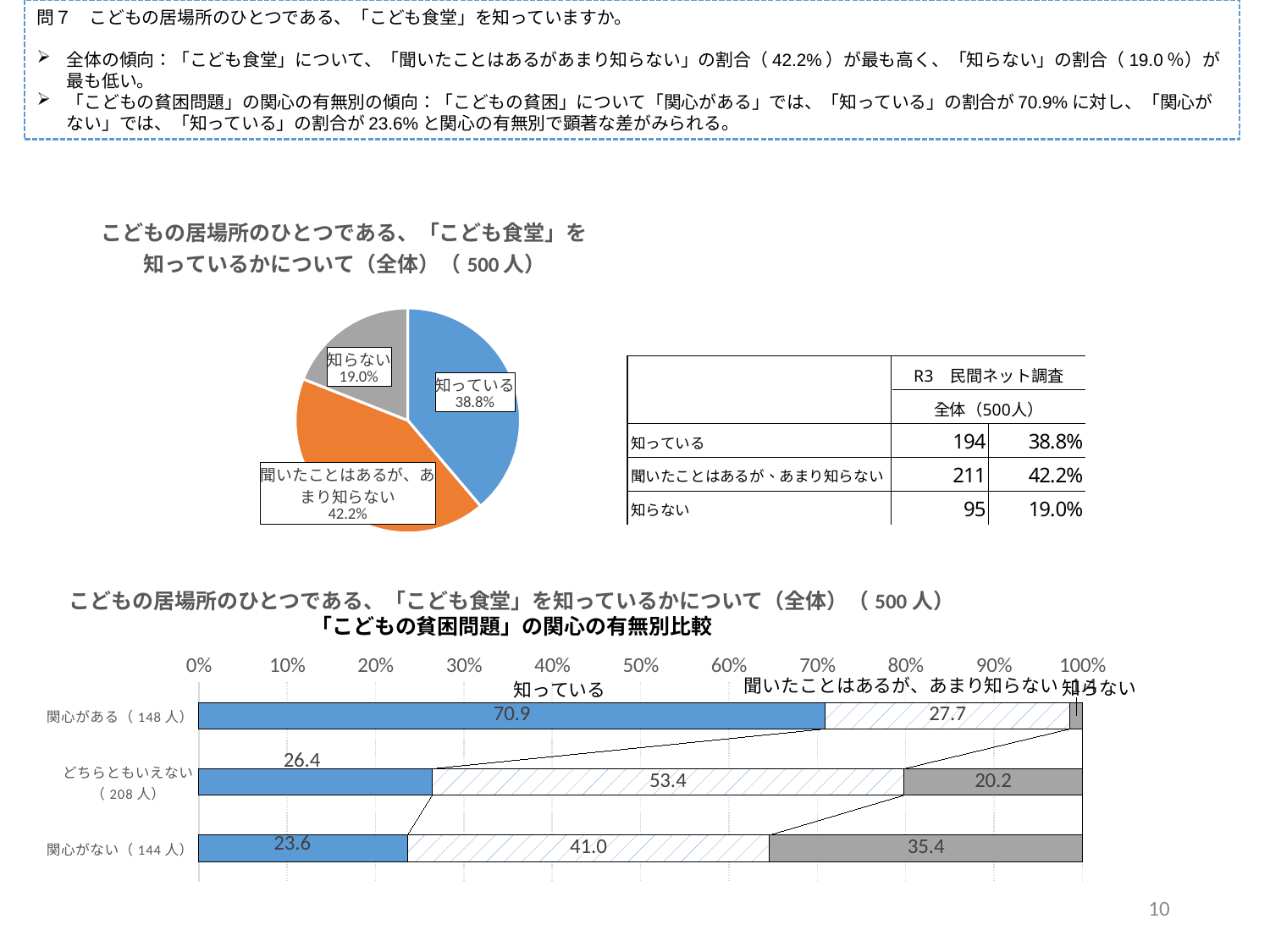
In the pie chart, what percentage of respondents answered 「知っている」? 38.8% What kind of chart is the bottom chart on the slide? Bar chart In the pie chart, which response has the smallest share? 知らない What kind of chart is the upper chart on the slide? Pie chart In the pie chart, which response has the largest share? 聞いたことはあるが、あまり知らない How many slices does the pie chart have? 3 In the bottom bar chart, what is the difference in the 「知っている」 value between 関心がある and 関心がない? 47.3 In the bottom bar chart, what is the value of 「知っている」 for 関心がある (148人)? 70.9 In the bottom bar chart, what is the value of 「知らない」 for 関心がない (144人)? 35.4 In the bottom bar chart, what is the value of 「聞いたことはあるが、あまり知らない」 for どちらともいえない (208人)? 53.4 In the bottom bar chart, which group has the larger 「知らない」 value, どちらともいえない or 関心がない? 関心がない How many categories (groups) are shown on the vertical axis of the bottom bar chart? 3